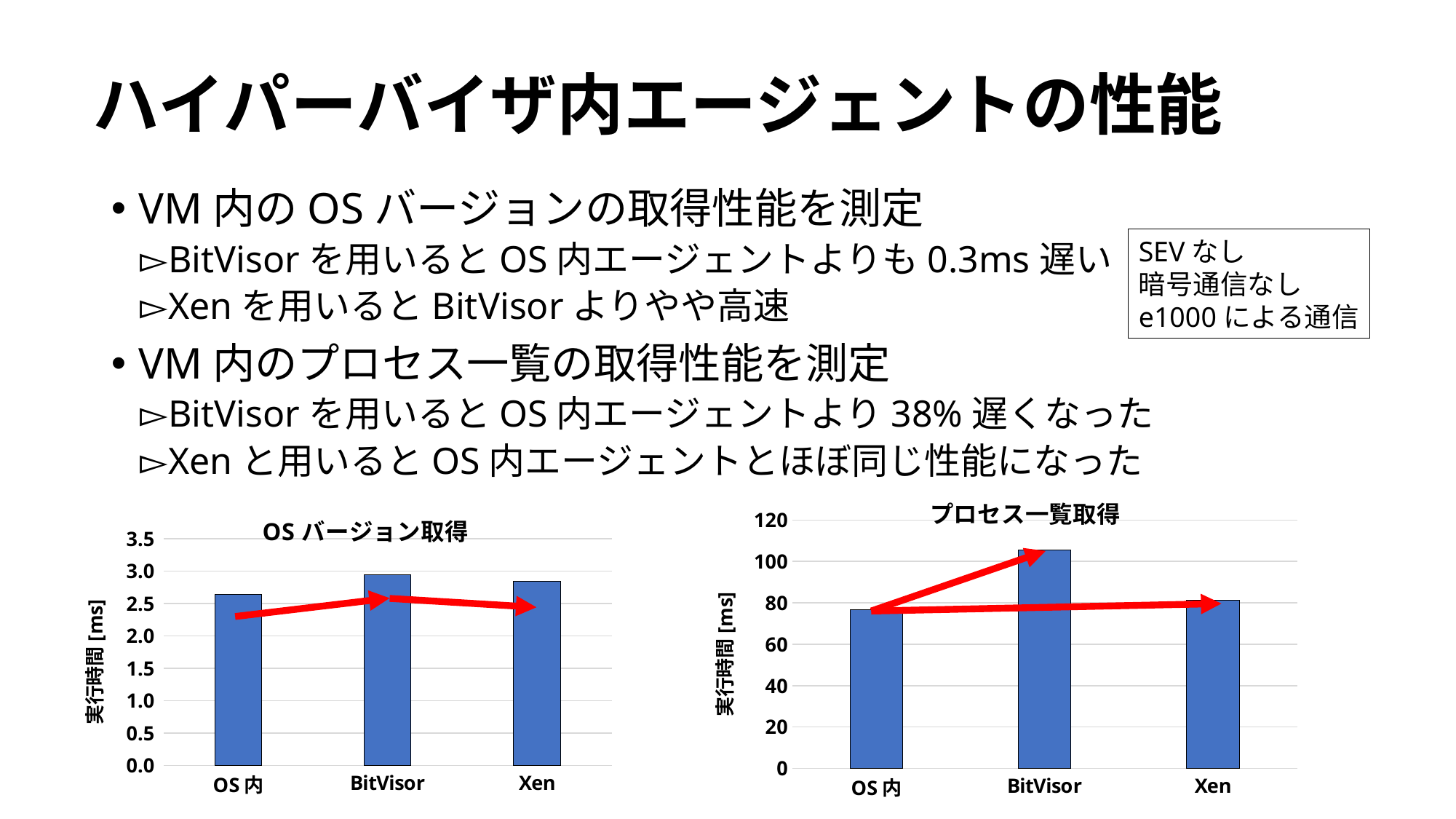
What kind of chart is the "OS バージョン取得" chart on the left? bar chart In the "プロセス一覧取得" chart, is the value for Xen greater or less than 100? less In the "OS バージョン取得" chart, which category has the lowest execution time? OS 内 In the "プロセス一覧取得" chart, is the value for BitVisor greater or less than 100? greater In the "OS バージョン取得" chart, is the value for OS 内 greater or less than 2.5? greater How many categories are shown on the x axis of the "プロセス一覧取得" chart on the right? 3 In the "プロセス一覧取得" chart, which category has the highest execution time? BitVisor What is the title of the chart on the left of the slide? OS バージョン取得 In the "OS バージョン取得" chart, which is larger, the value for OS 内 or the value for Xen? Xen What is the y-axis label of the "プロセス一覧取得" chart? 実行時間 [ms]